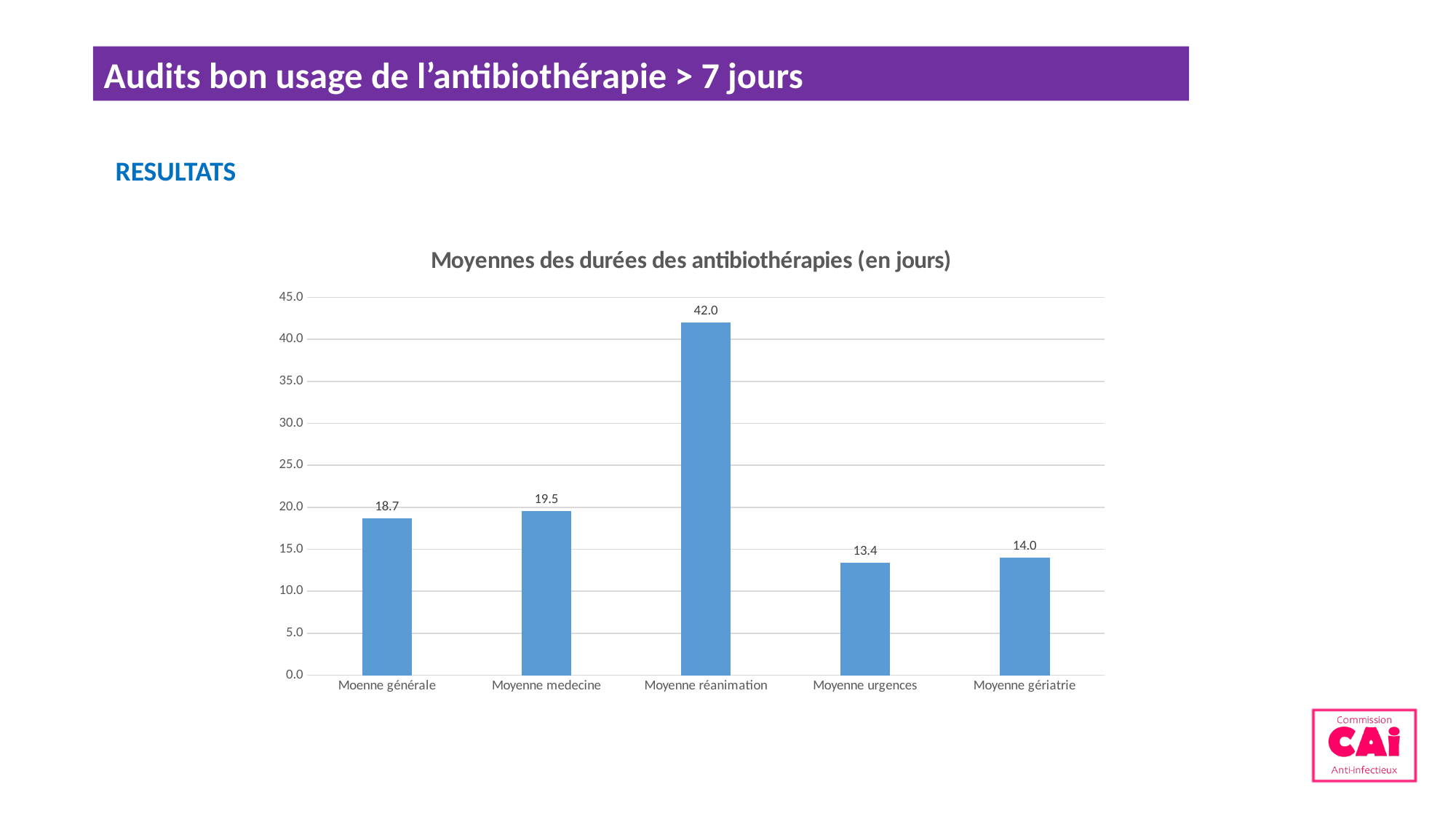
What is the difference between Moyenne réanimation and Moyenne medecine? 22.5 Which category has the highest value? Moyenne réanimation What kind of chart is shown on the slide? bar chart How many categories are shown on the chart? 5 Which category has the lowest value? Moyenne urgences What is the value for Moyenne réanimation? 42.0 What is the value for Moyenne gériatrie? 14.0 Is the value for Moyenne réanimation greater or less than 40.0? greater What is the value for Moyenne urgences? 13.4 What is the value for Moenne générale? 18.7 What is the title of the chart? Moyennes des durées des antibiothérapies (en jours) Which is larger, Moyenne medecine or Moenne générale? Moyenne medecine